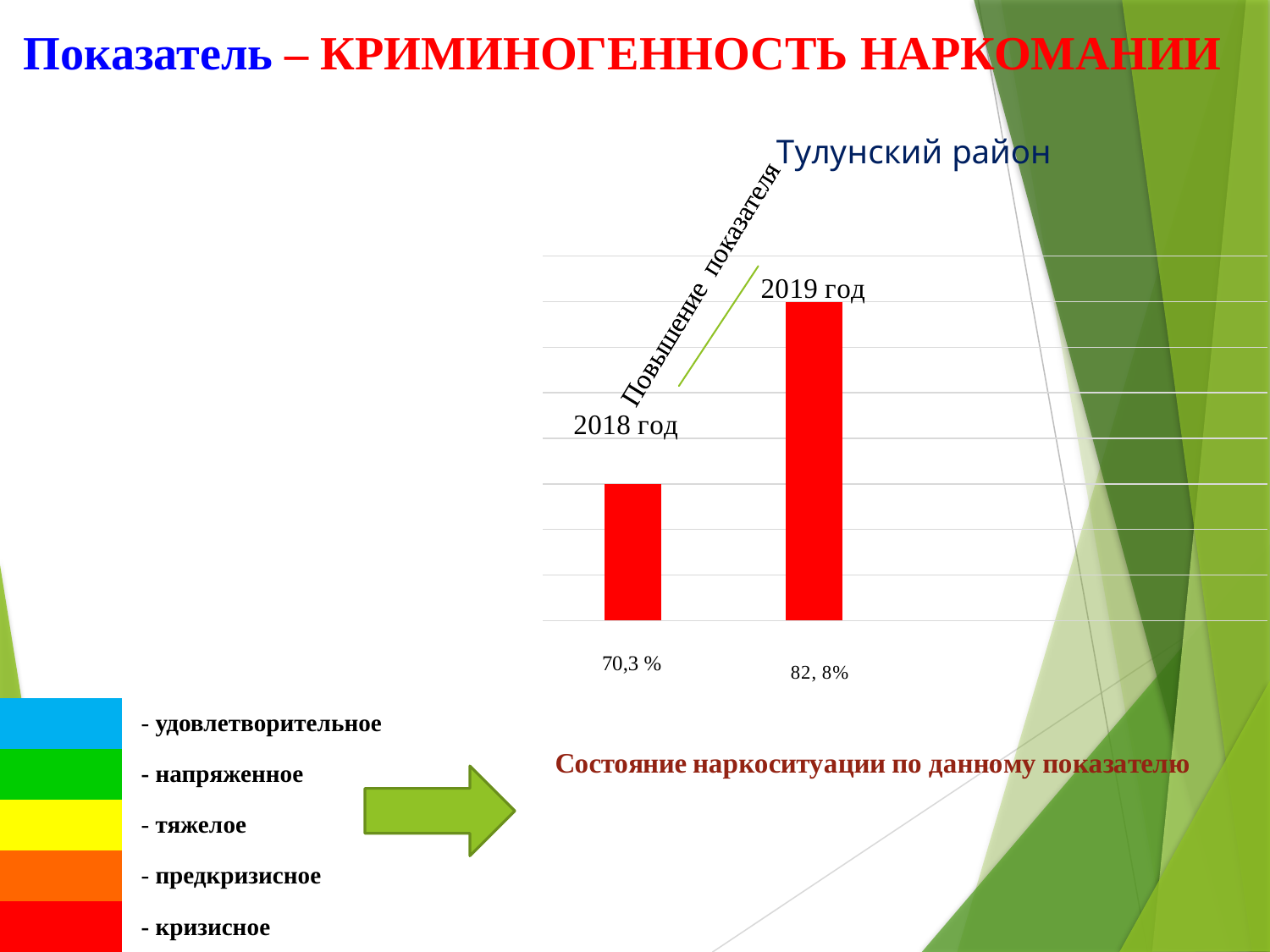
What is the title of the chart? Тулунский район Is the value for 2019 год larger or smaller than the value for 2018 год? larger How many bars are plotted in the chart? 2 What is the value for 2018 год? 70,3 % Which year has the higher value? 2019 год Do the values rise or fall from 2018 год to 2019 год? rise What colour are the bars in the chart? red By how much does the value for 2019 год exceed the value for 2018 год? 12,5 % What kind of chart is shown on the slide? bar chart What is the value for 2019 год? 82, 8% Which year has the lower value? 2018 год